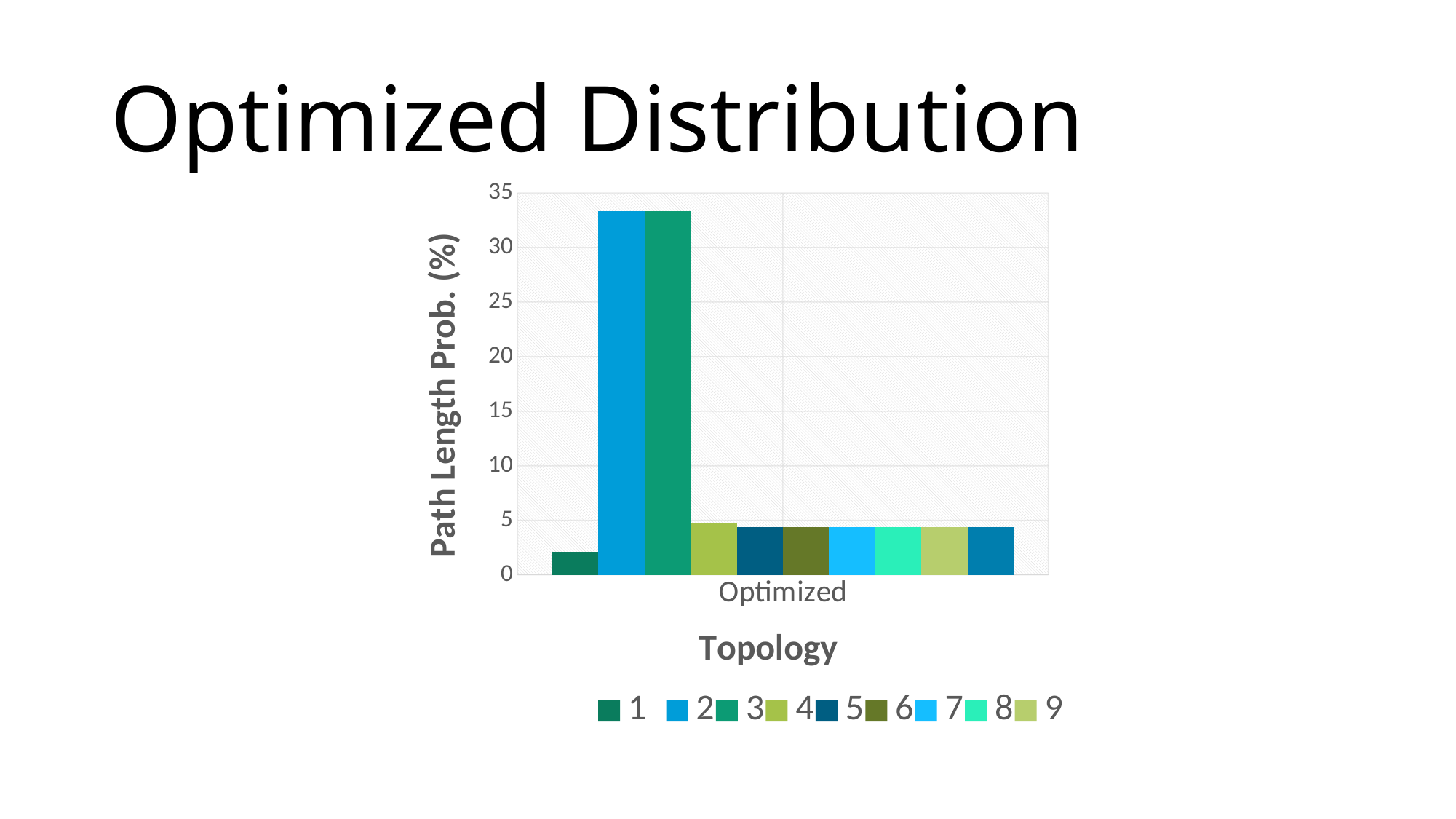
Which is larger, the value for series 2 or the value for series 1? 2 Is the value for series 3 greater or less than 30? greater How many series does the legend list? 9 What is the title of the y axis? Path Length Prob. (%) Is the value for series 1 greater or less than 5? less What kind of chart is shown on the slide? bar chart Is the value for series 2 greater or less than 30? greater Which is larger, the value for series 1 or the value for series 4? 4 How many categories are shown on the x axis? 1 What is the label of the category on the x axis? Optimized Which series has the lowest value for Optimized? 1